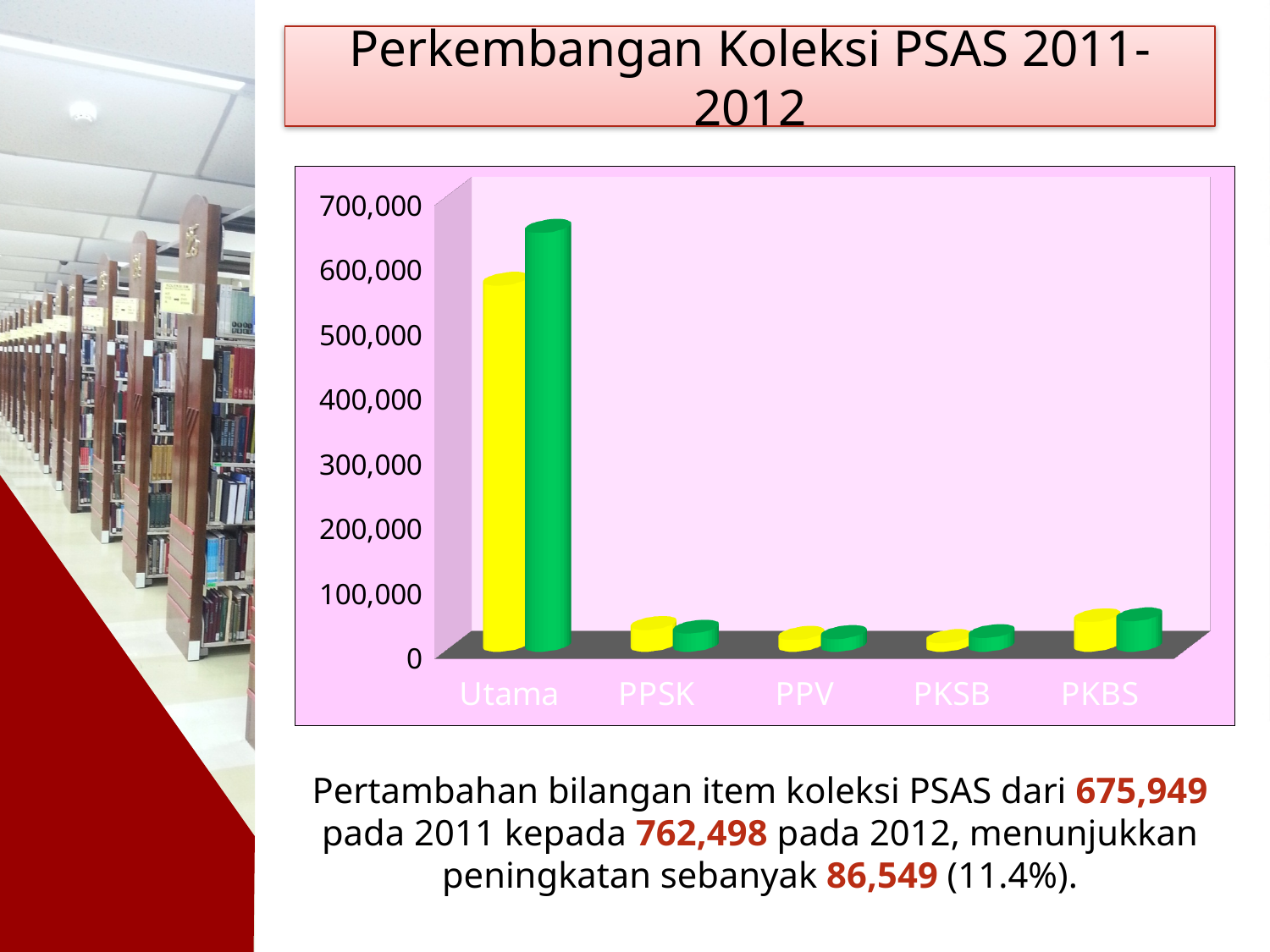
Is the green bar for PKBS greater or less than 100,000? less Is the yellow bar for PPSK greater or less than 100,000? less Which category has the highest bars in the chart? Utama How many bars are shown for each category in the chart? 2 What is the title of the slide containing the chart? Perkembangan Koleksi PSAS 2011-2012 Is the yellow bar for Utama greater or less than 500,000? greater How many categories are shown on the x axis of the chart? 5 What kind of chart is shown on the slide? bar chart Which is larger, the green bar for Utama or the green bar for PPSK? Utama